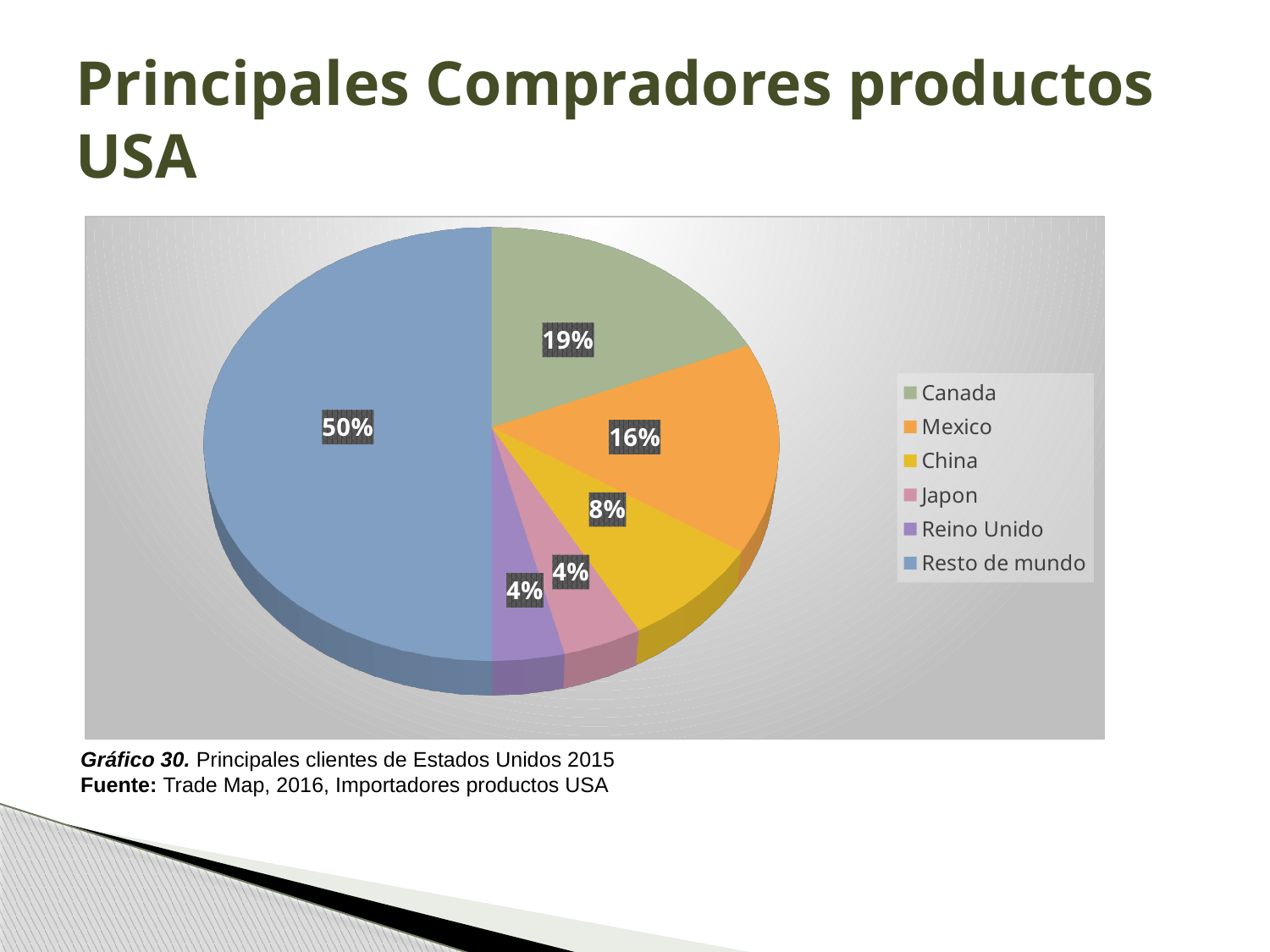
What is the difference between the shares of Canada and Mexico? 3% Which is larger, the share for Mexico or the share for China? Mexico What share of the pie does China hold? 8% What share of the pie does Mexico hold? 16% What share of the pie does Resto de mundo hold? 50% How many categories does the legend list? 6 What is the combined share of Canada, Mexico and China? 43% What is the difference between the shares of Resto de mundo and Canada? 31% Which category has the largest slice of the pie? Resto de mundo What share of the pie does Canada hold? 19% What colour is the slice for Resto de mundo? blue What type of chart is shown on the slide? pie chart